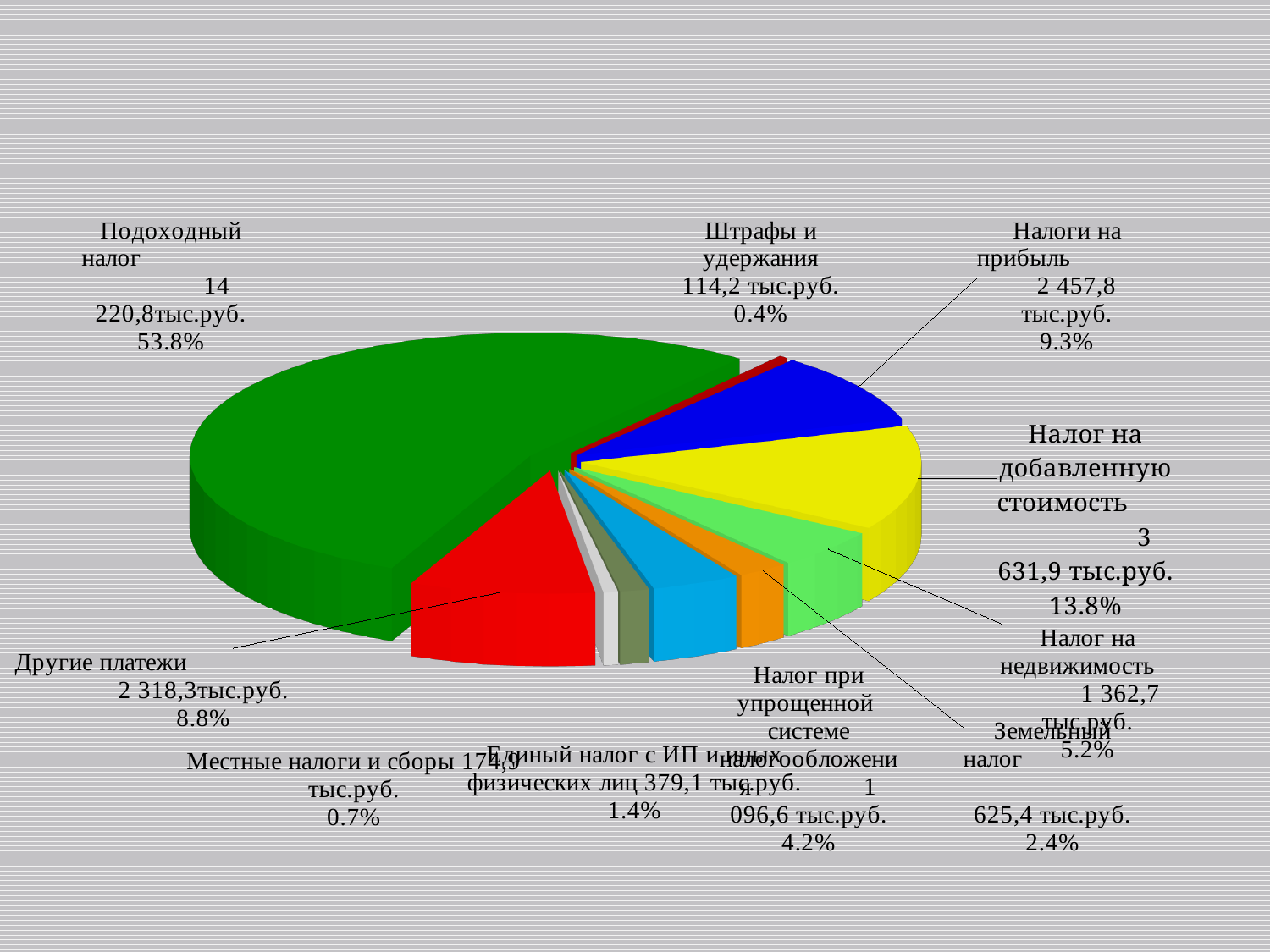
What colour is the slice for Подоходный налог? green What percentage is shown for Земельный налог? 2.4% What is the difference in percentage points between the share for Налог на добавленную стоимость and the share for Налог на недвижимость? 8.6 What share of the pie does Подоходный налог have? 53.8% What percentage is shown for Штрафы и удержания? 0.4% What is the value shown for Налоги на прибыль? 2 457,8 тыс.руб. Which is larger: the share for Налоги на прибыль or the share for Другие платежи? Налоги на прибыль How many categories (slices) does the pie chart show? 10 Which category has the largest slice of the pie? Подоходный налог What is the value shown for Налог на добавленную стоимость? 3 631,9 тыс.руб. Which category has the smallest slice of the pie? Штрафы и удержания What kind of chart is shown on the slide? pie chart